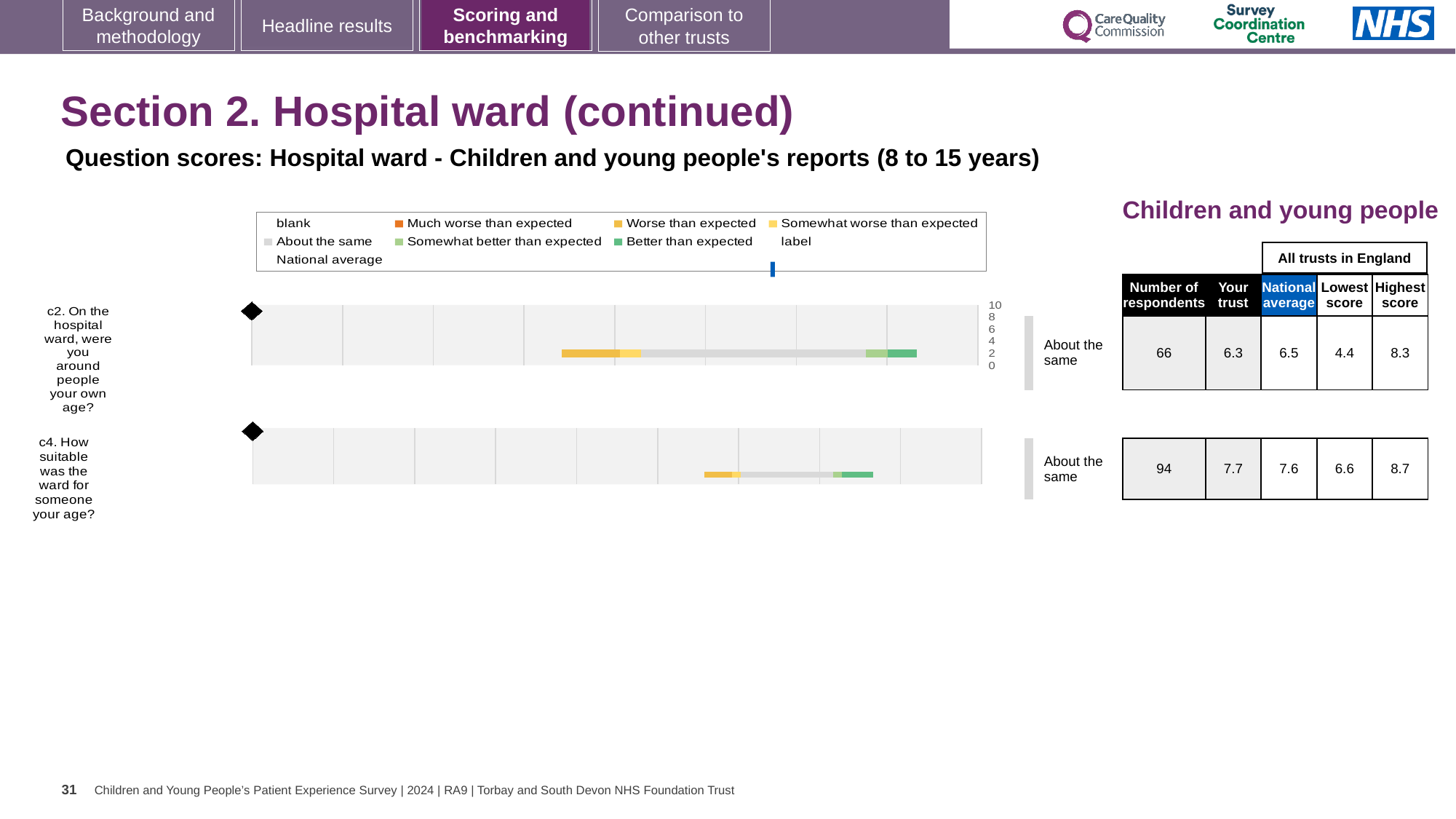
What is the highest score among all trusts in England for question c4? 8.7 What is the lowest score among all trusts in England for question c2? 4.4 What kind of chart is used to show the question scores for c2 and c4? bar chart What is the maximum value shown on the chart's score axis? 10 How many questions (chart rows) are plotted on the slide? 2 What is the difference between the 'Your trust' score and the national average for question c4? 0.1 What is the 'Your trust' score for question c4 (How suitable was the ward for someone your age?)? 7.7 What is the national average score for question c2? 6.5 What benchmark category is shown for question c2? About the same What is the 'Your trust' score for question c2 (On the hospital ward, were you around people your own age?)? 6.3 How many respondents answered question c4? 94 Which question has the higher 'Your trust' score, c2 or c4? c4